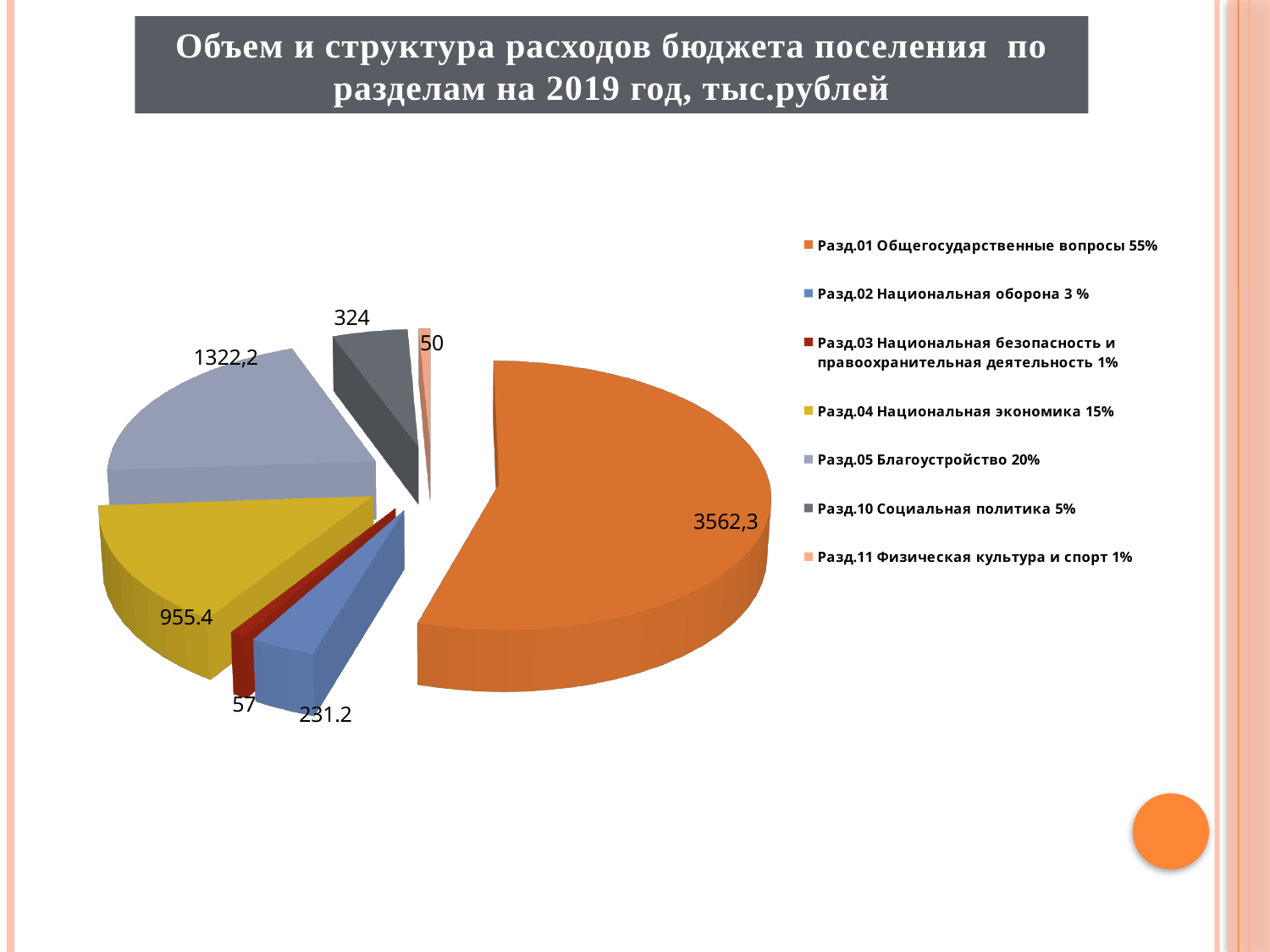
What is the value for Разд.10 Социальная политика? 324 What share of the pie does Разд.05 Благоустройство represent according to the legend? 20% Which is larger: the value for Разд.02 Национальная оборона or Разд.03 Национальная безопасность и правоохранительная деятельность? Разд.02 Национальная оборона What is the difference between the values for Разд.10 Социальная политика and Разд.11 Физическая культура и спорт? 274 What is the value for Разд.04 Национальная экономика? 955.4 What type of chart is shown on the slide? pie chart How many sections (slices) does the pie chart show? 7 Which section has the largest share of the budget expenditures? Разд.01 Общегосударственные вопросы What is the value for Разд.01 Общегосударственные вопросы? 3562,3 What is the value for Разд.05 Благоустройство? 1322,2 What is the title of the chart on the slide? Объем и структура расходов бюджета поселения по разделам на 2019 год, тыс.рублей Which section has the smallest value on the chart? Разд.11 Физическая культура и спорт